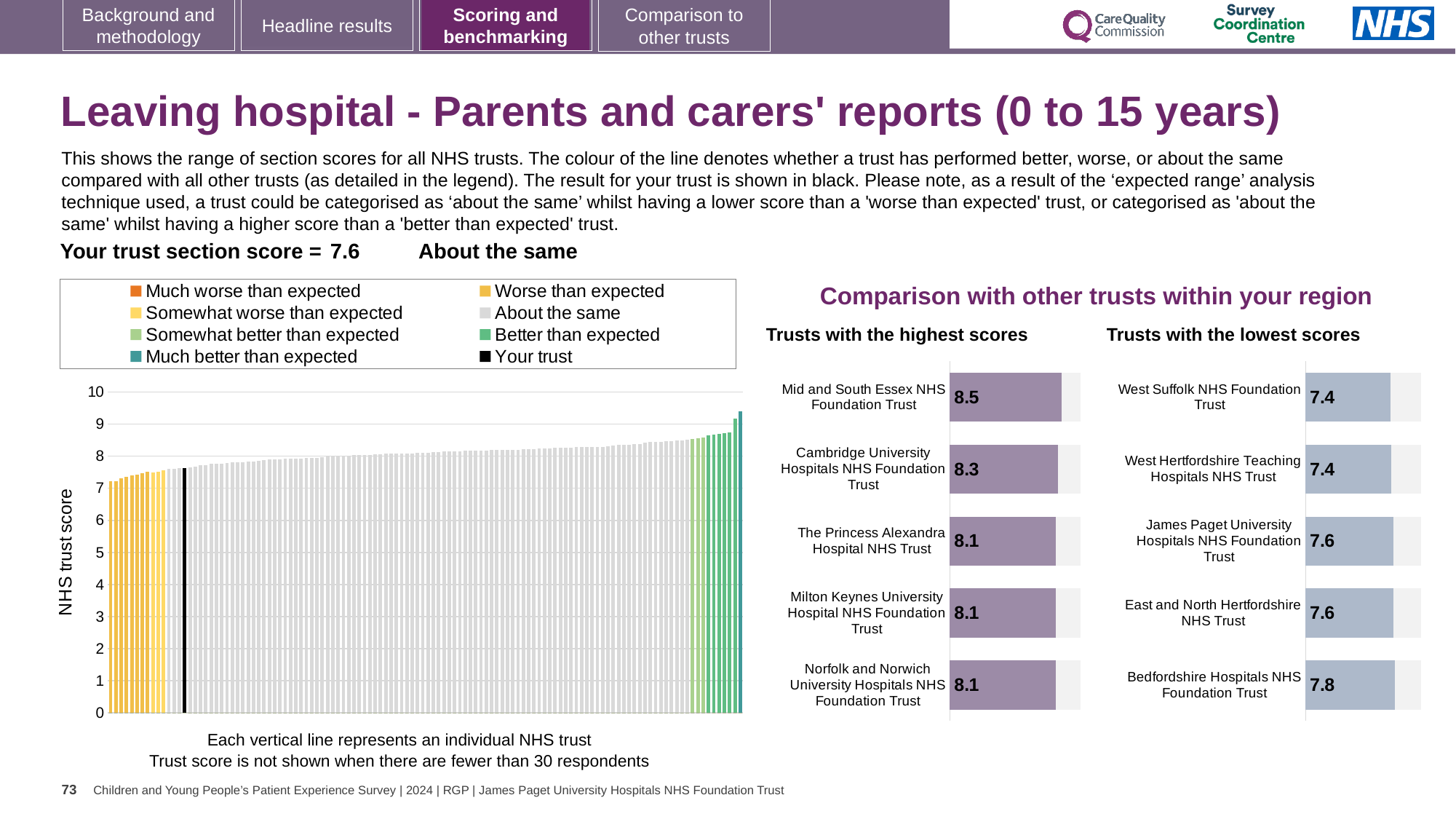
In the 'Trusts with the lowest scores' chart, which is larger: the score for James Paget University Hospitals NHS Foundation Trust or the score for Bedfordshire Hospitals NHS Foundation Trust? Bedfordshire Hospitals NHS Foundation Trust In the 'Trusts with the highest scores' chart, which trust has the highest score? Mid and South Essex NHS Foundation Trust In the 'Trusts with the highest scores' chart, how many trusts are shown? 5 In the 'Trusts with the lowest scores' chart, which trust has the highest score? Bedfordshire Hospitals NHS Foundation Trust What is the difference between the score for Mid and South Essex NHS Foundation Trust in the 'highest scores' chart and the score for West Suffolk NHS Foundation Trust in the 'lowest scores' chart? 1.1 In the main chart on the left showing all NHS trusts, what is the section score for your trust (the black line)? 7.6 In the main chart on the left showing all NHS trusts, do the trust scores rise or fall from left to right? rise In the 'Trusts with the lowest scores' chart, what is the score for West Suffolk NHS Foundation Trust? 7.4 In the 'Trusts with the highest scores' chart, what is the score for Mid and South Essex NHS Foundation Trust? 8.5 In the 'Trusts with the highest scores' chart, what is the score for Cambridge University Hospitals NHS Foundation Trust? 8.3 In the 'Trusts with the lowest scores' chart, what is the score for Bedfordshire Hospitals NHS Foundation Trust? 7.8 How many entries does the legend of the main chart on the left list? 8